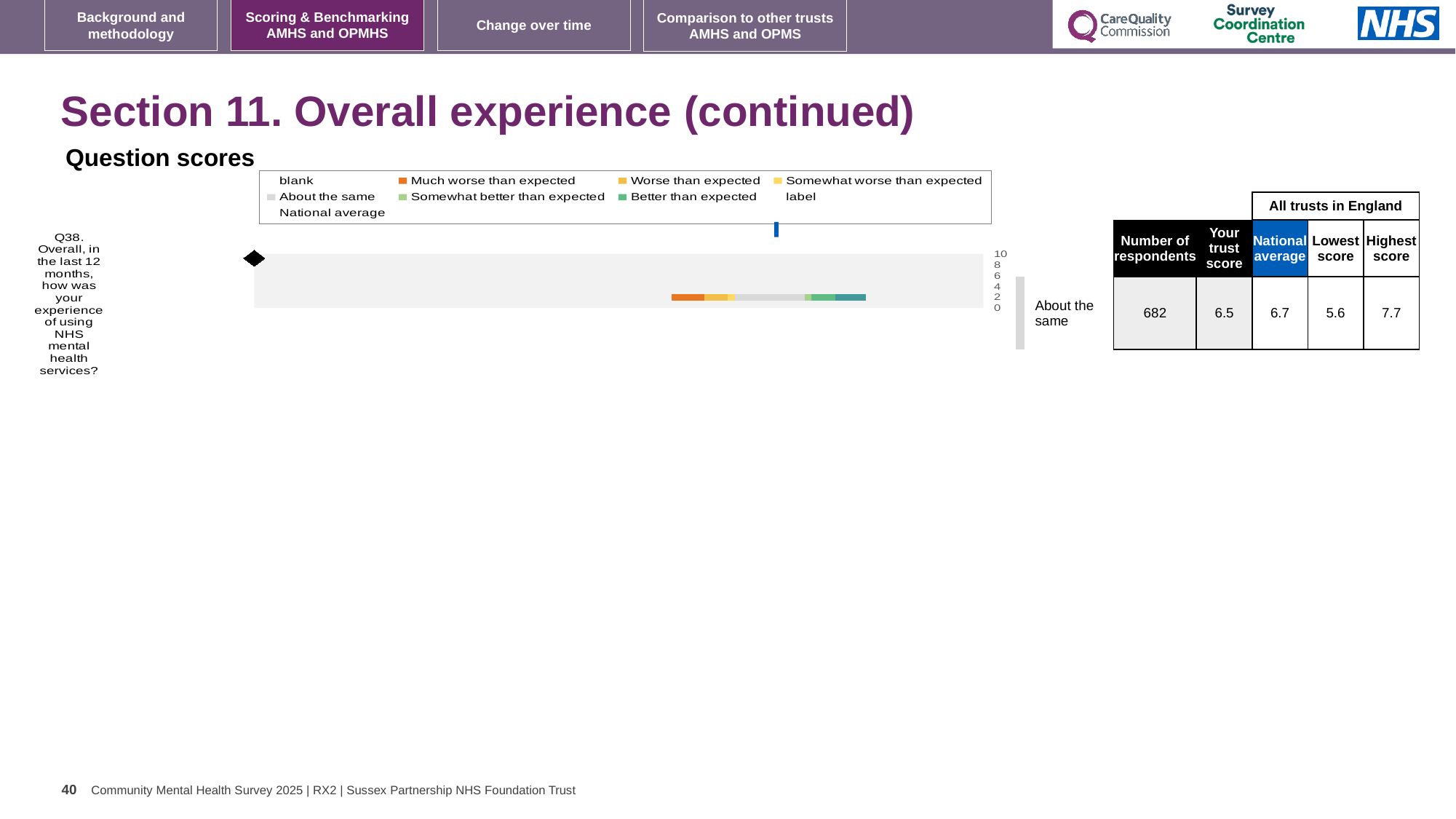
How many respondents answered Q38? 682 Is the trust score for Q38 greater or less than 6 on the chart's axis? greater What is the difference between the highest score and the lowest score for Q38? 2.1 What is the highest score among all trusts in England for Q38? 7.7 What is the trust score for Q38? 6.5 What is the national average score for Q38? 6.7 What is the lowest score among all trusts in England for Q38? 5.6 How many survey questions are plotted in the Question scores chart? 1 Which question number is plotted in the Question scores chart? Q38 What benchmark category is shown to the right of the bar for Q38? About the same What kind of chart is shown under 'Question scores'? bar chart For Q38, which is larger: the trust score or the national average? National average